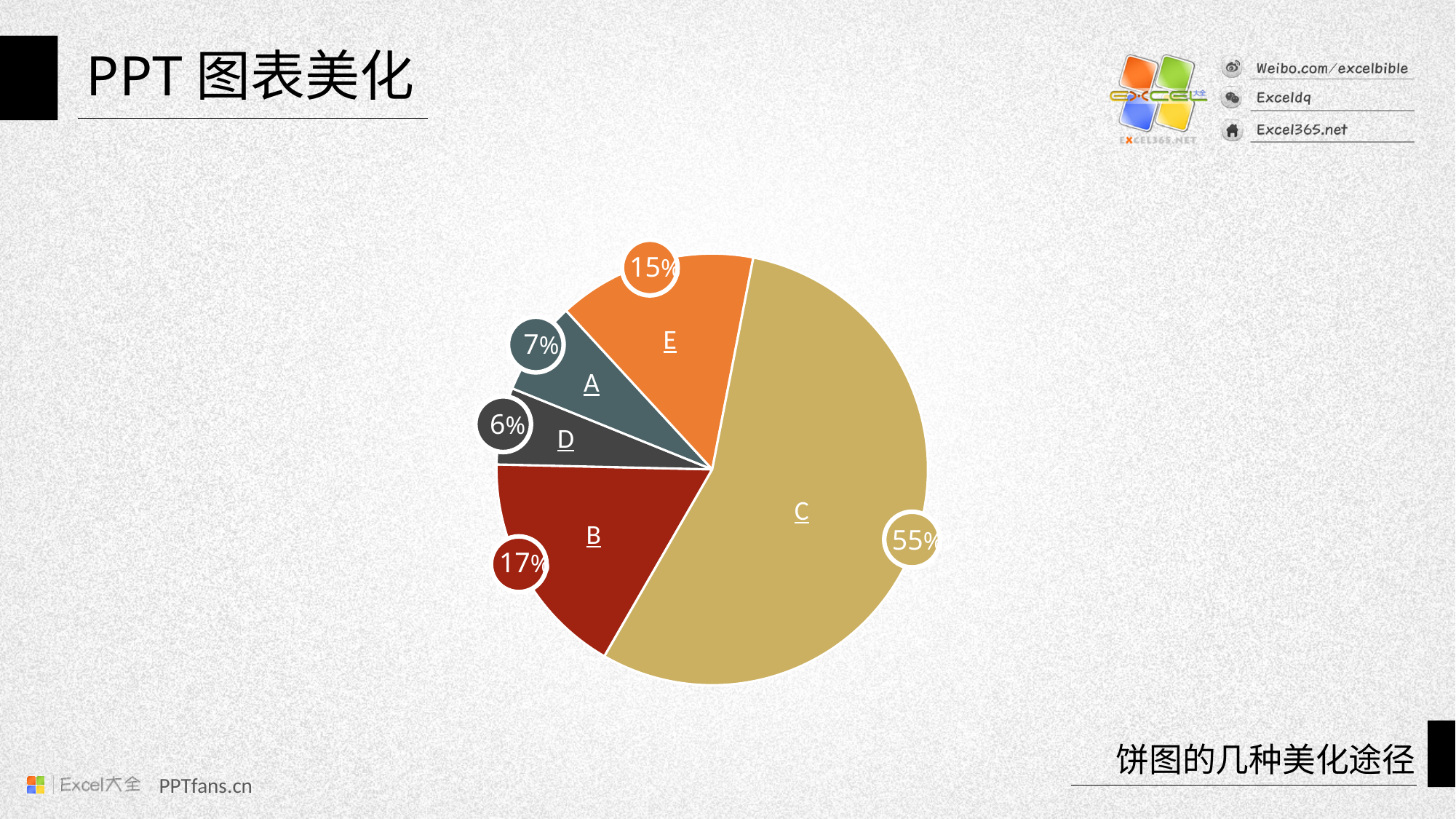
Which is larger, slice B or slice E? B What percentage does slice D represent? 6% Which slice is the largest? C What percentage does slice C represent? 55% What percentage does slice A represent? 7% What colour is slice C? gold What percentage does slice B represent? 17% How many slices does the pie chart have? 5 Which slice is the smallest? D What is the difference in percentage points between slice C and slice B? 38 What kind of chart is shown on the slide? pie chart What percentage does slice E represent? 15%